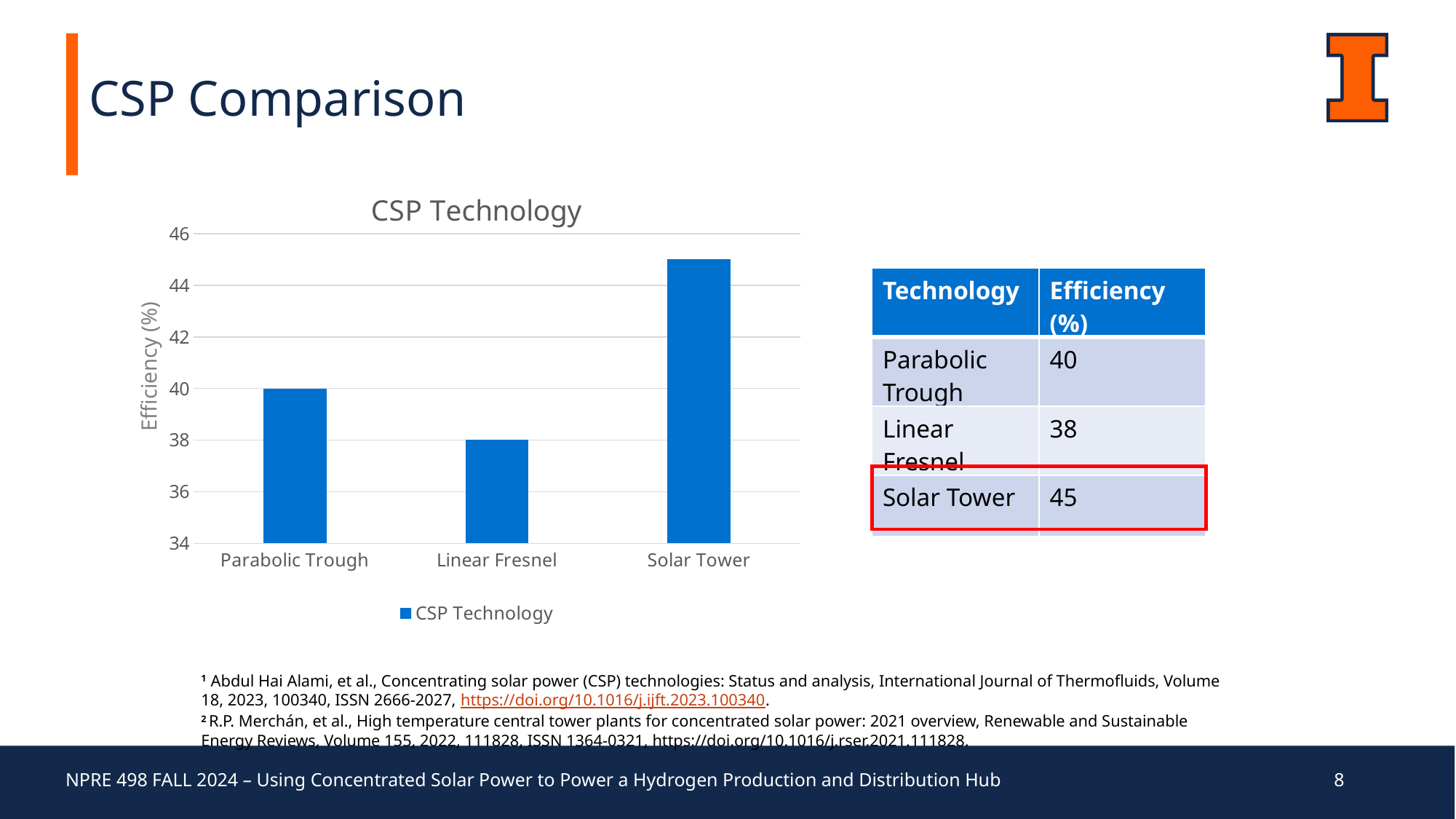
How many technologies are shown in the CSP Technology chart? 3 What is the efficiency value for Linear Fresnel in the CSP Technology chart? 38 Which has a higher efficiency, Parabolic Trough or Solar Tower? Solar Tower What is the label on the y axis of the CSP Technology chart? Efficiency (%) What type of chart is the CSP Technology chart? bar chart What is the efficiency value for Parabolic Trough in the CSP Technology chart? 40 Which technology has the lowest efficiency in the CSP Technology chart? Linear Fresnel Which technology has the highest efficiency in the CSP Technology chart? Solar Tower What is the difference in efficiency between Solar Tower and Linear Fresnel? 7 What is the difference in efficiency between Parabolic Trough and Linear Fresnel? 2 What is the efficiency value for Solar Tower in the CSP Technology chart? 45 Is the value for Solar Tower greater or less than 44? greater